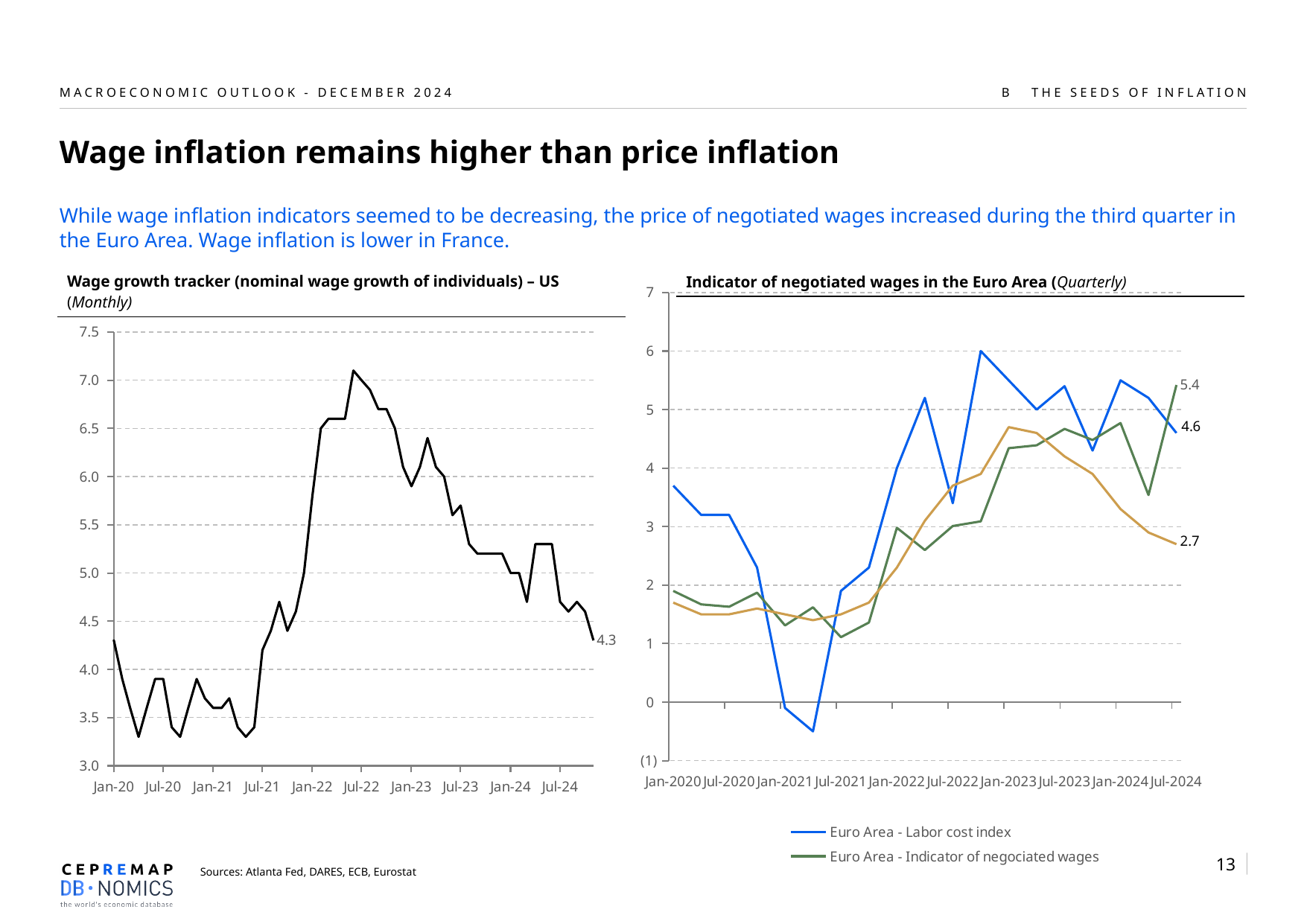
On the left chart, does the line generally rise or fall between Jul-22 and Jul-24? Fall On the right chart (Indicator of negotiated wages in the Euro Area), what is the final value printed for the Euro Area - Labor cost index? 4.6 On the left chart (Wage growth tracker – US), what is the value printed at the end of the line? 4.3 On the right chart, what is the difference between the final printed values of the Indicator of negociated wages (5.4) and the Labor cost index (4.6)? 0.8 On the right chart, is the peak value of the Euro Area - Labor cost index greater or less than 5? greater On the left chart, is the peak value of the line greater or less than 6.5? greater What kind of chart is the left chart (Wage growth tracker – US)? Line chart On the right chart, is the lowest value of the Euro Area - Labor cost index greater or less than 0? less On the right chart, which series ends higher at Jul-2024: the Labor cost index or the Indicator of negociated wages? Euro Area - Indicator of negociated wages How many series does the legend of the right chart list? 2 On the right chart (Indicator of negotiated wages in the Euro Area), what is the final value printed for the Euro Area - Indicator of negociated wages? 5.4 On the right chart, which series is drawn in blue? Euro Area - Labor cost index